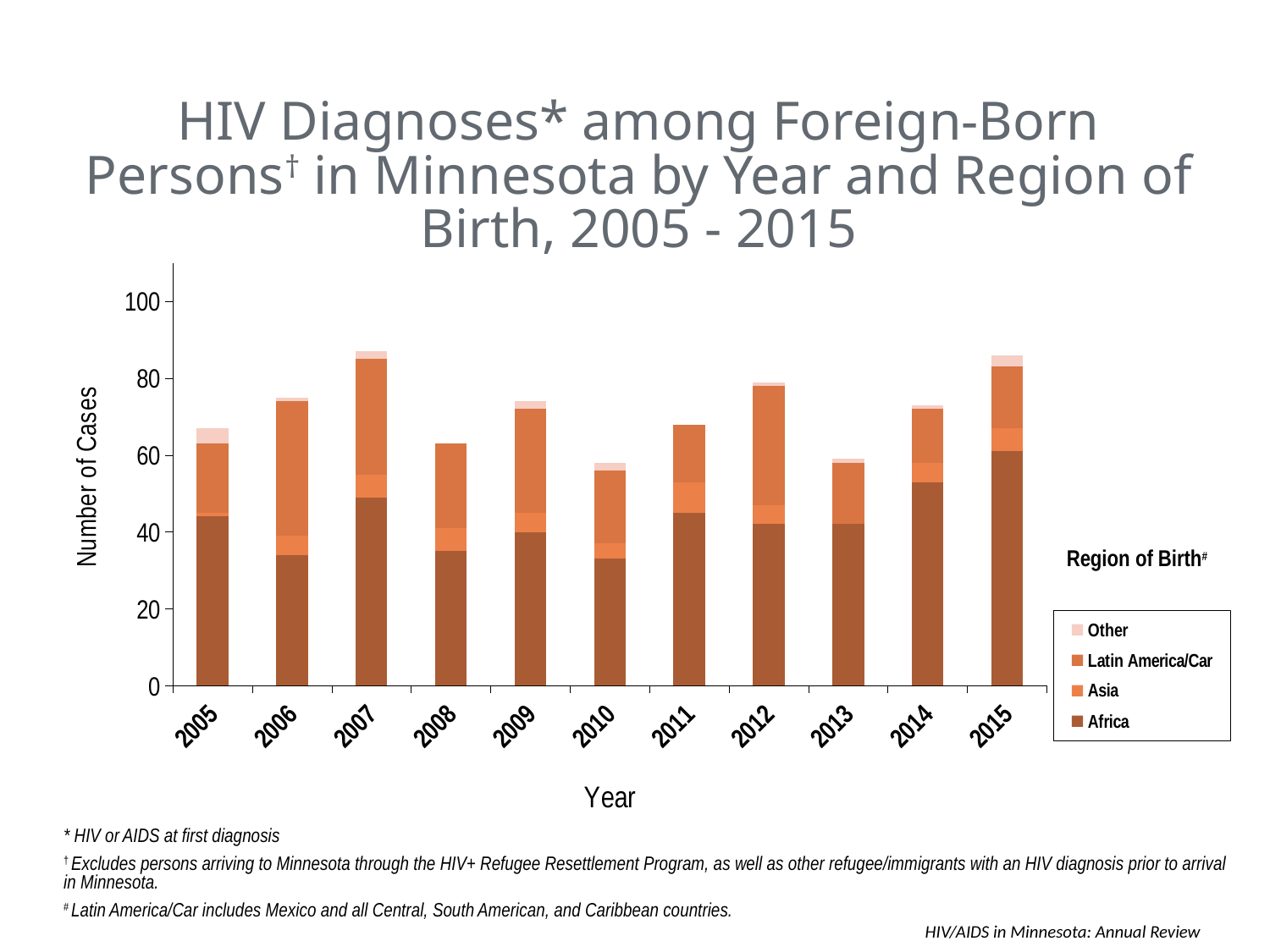
Which year has more cases for Africa, 2006 or 2014? 2014 What is the label on the y axis of the chart? Number of Cases Is the total number of cases for 2007 greater or less than 80? greater Which year has a larger total number of cases, 2007 or 2010? 2007 How many regions of birth does the legend list? 4 How many years are shown along the x axis of the chart? 11 Is the total number of cases for 2010 greater or less than 60? less Is the number of cases for Africa in 2014 greater or less than 40? greater In which year is the Africa segment the largest? 2015 What kind of chart is shown on the slide? Stacked bar chart